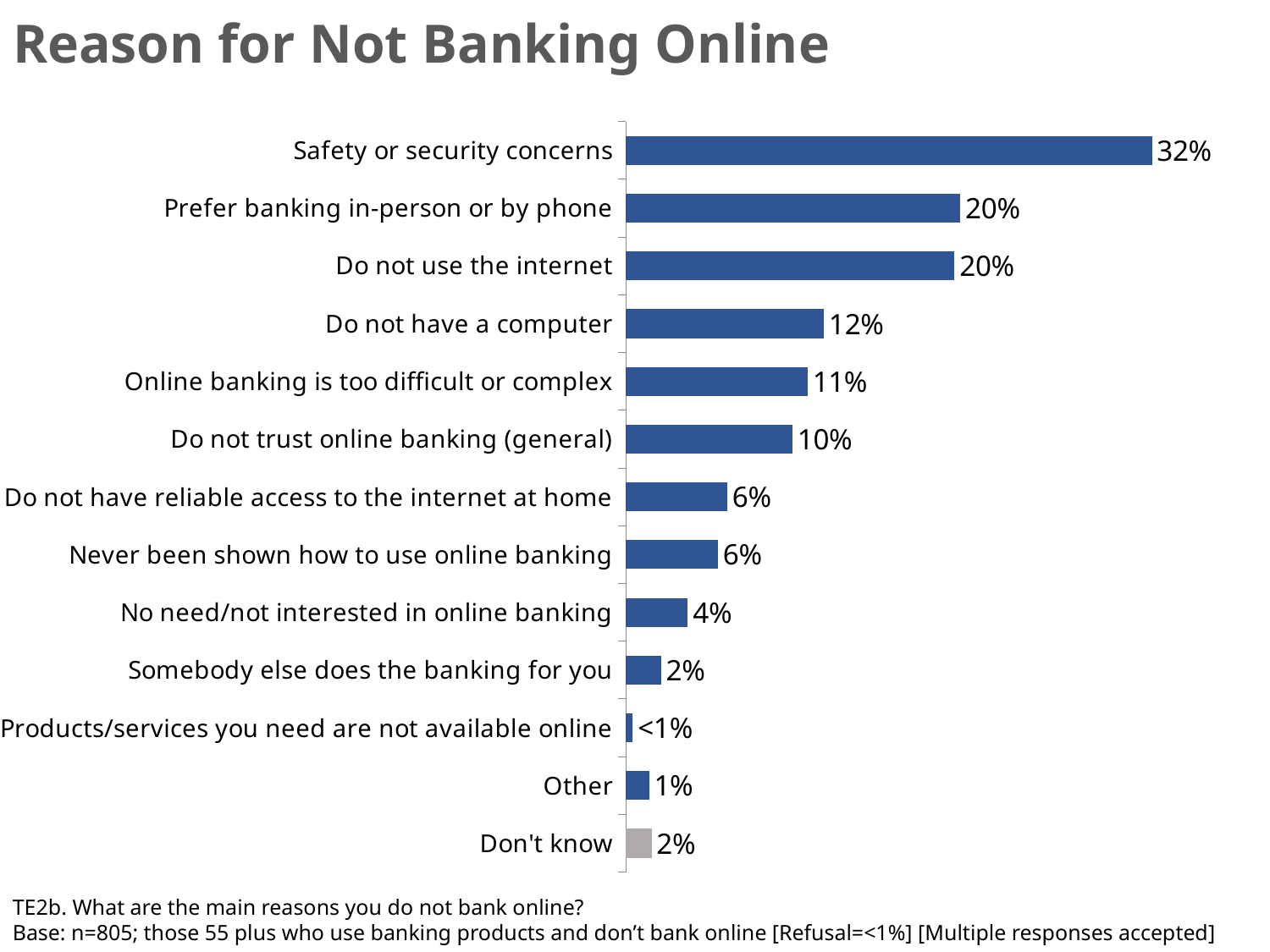
What is the value for "Do not have a computer"? 12% What is the value for "Products/services you need are not available online"? <1% What percentage said online banking is too difficult or complex? 11% Which category's bar is shown in grey rather than blue? Don't know How many categories are shown in the chart? 13 Which is larger: "Do not trust online banking (general)" or "No need/not interested in online banking"? Do not trust online banking (general) Which reason has the lowest percentage? Products/services you need are not available online What percentage cited safety or security concerns as a reason for not banking online? 32% Which reason has the highest percentage? Safety or security concerns What is the title of the chart? Reason for Not Banking Online What type of chart is shown on the slide? Bar chart What is the difference between "Safety or security concerns" and "Do not use the internet"? 12 percentage points